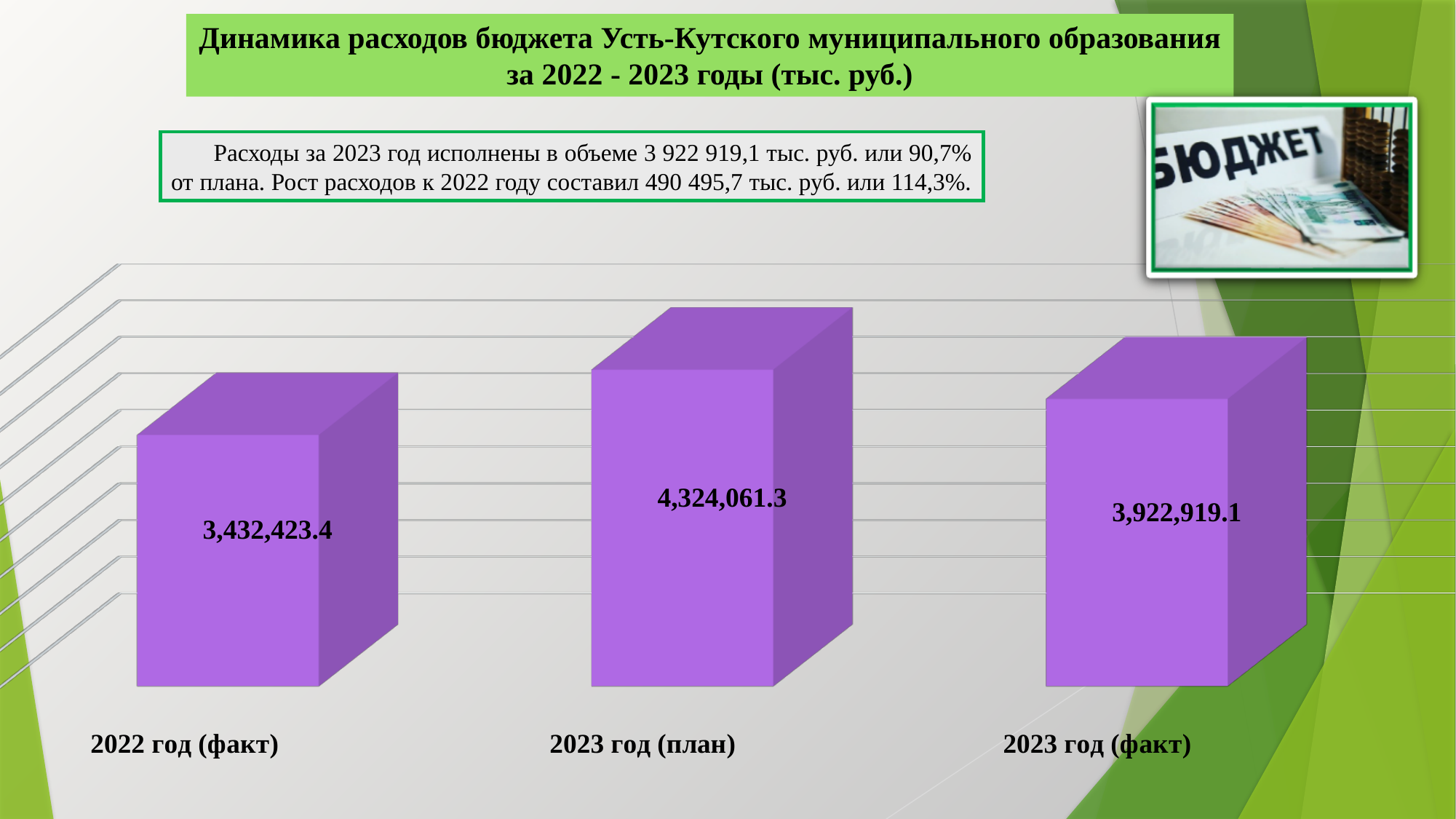
Which is larger, the value for 2023 год (факт) or the value for 2022 год (факт)? 2023 год (факт) How many categories are shown in the chart? 3 What is the value for 2023 год (план)? 4,324,061.3 Which category has the highest value? 2023 год (план) Which category has the lowest value? 2022 год (факт) What is the difference between the values for 2023 год (факт) and 2022 год (факт)? 490,495.7 What is the value for 2023 год (факт)? 3,922,919.1 What is the value for 2022 год (факт)? 3,432,423.4 Does the value rise or fall from 2022 год (факт) to 2023 год (план)? rise What kind of chart is shown on the slide? bar chart What is the difference between the values for 2023 год (план) and 2023 год (факт)? 401,142.2 What colour are the bars in the chart? purple